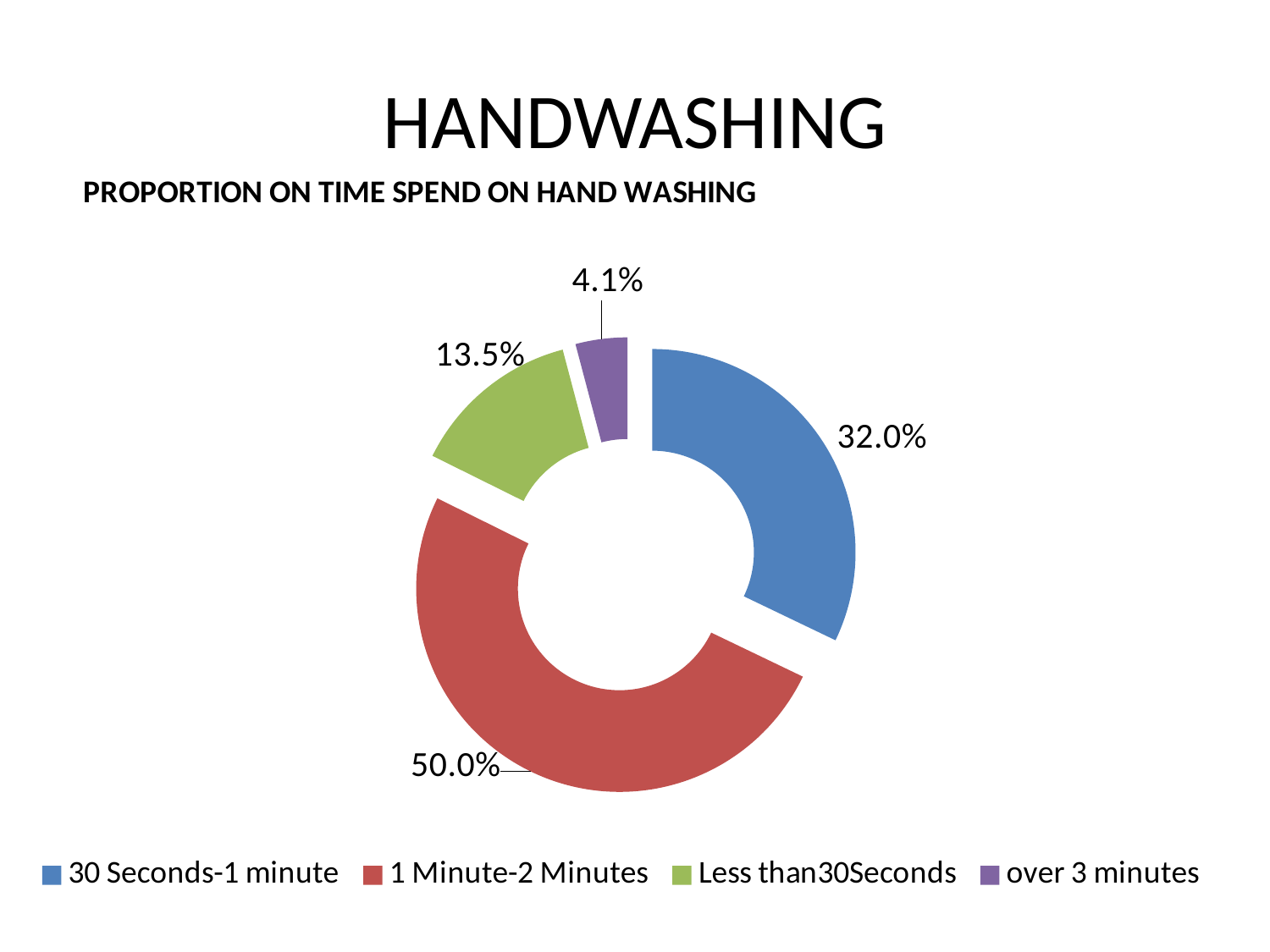
Which is larger, the share for 'Less than30Seconds' or the share for 'over 3 minutes'? Less than30Seconds What is the difference between the shares for '1 Minute-2 Minutes' and '30 Seconds-1 minute'? 18.0% What share of the chart does the '1 Minute-2 Minutes' slice represent? 50.0% Which category has the largest share? 1 Minute-2 Minutes Which category has the smallest share? over 3 minutes What is the value shown for '30 Seconds-1 minute'? 32.0% How many categories does the chart show? 4 What is the value shown for 'Less than30Seconds'? 13.5% What colour is the '1 Minute-2 Minutes' slice? Red What is the value shown for 'over 3 minutes'? 4.1% What kind of chart is shown on the slide? Doughnut (pie) chart What is the title of the chart? PROPORTION ON TIME SPEND ON HAND WASHING